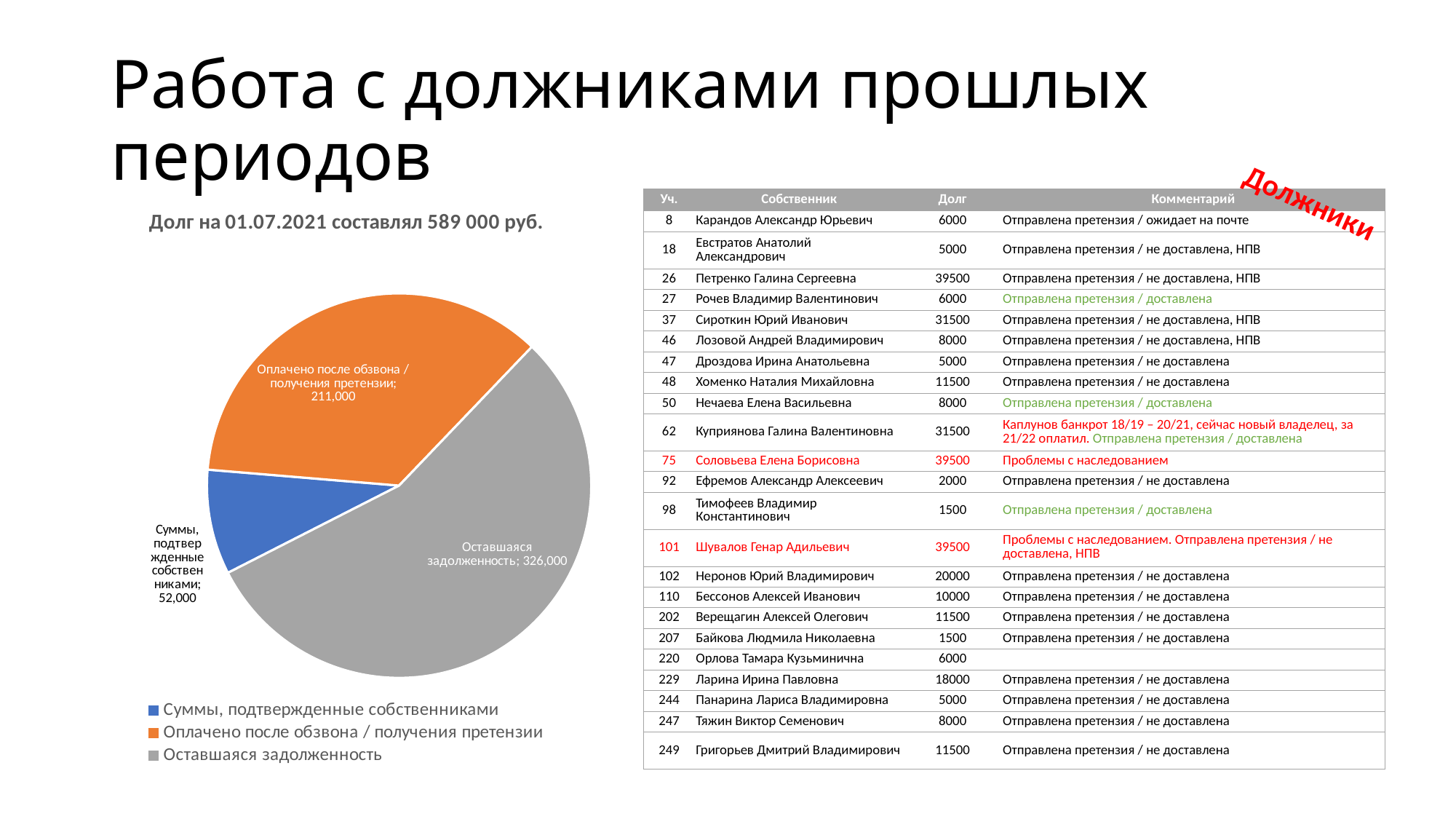
What colour is the 'Оставшаяся задолженность' slice in the pie chart? Grey What is the difference between 'Оплачено после обзвона / получения претензии' and 'Суммы, подтвержденные собственниками'? 159,000 How many slices does the pie chart have? 3 What is the difference between 'Оставшаяся задолженность' and 'Оплачено после обзвона / получения претензии'? 115,000 What is the total of all three slices in the pie chart? 589,000 What is the value of the 'Оставшаяся задолженность' slice in the pie chart? 326,000 What kind of chart is shown on the slide? Pie chart Which is larger: 'Оплачено после обзвона / получения претензии' or 'Суммы, подтвержденные собственниками'? Оплачено после обзвона / получения претензии What is the value of the 'Оплачено после обзвона / получения претензии' slice? 211,000 What is the value of the 'Суммы, подтвержденные собственниками' slice? 52,000 Which slice of the pie chart is the largest? Оставшаяся задолженность Which slice of the pie chart is the smallest? Суммы, подтвержденные собственниками